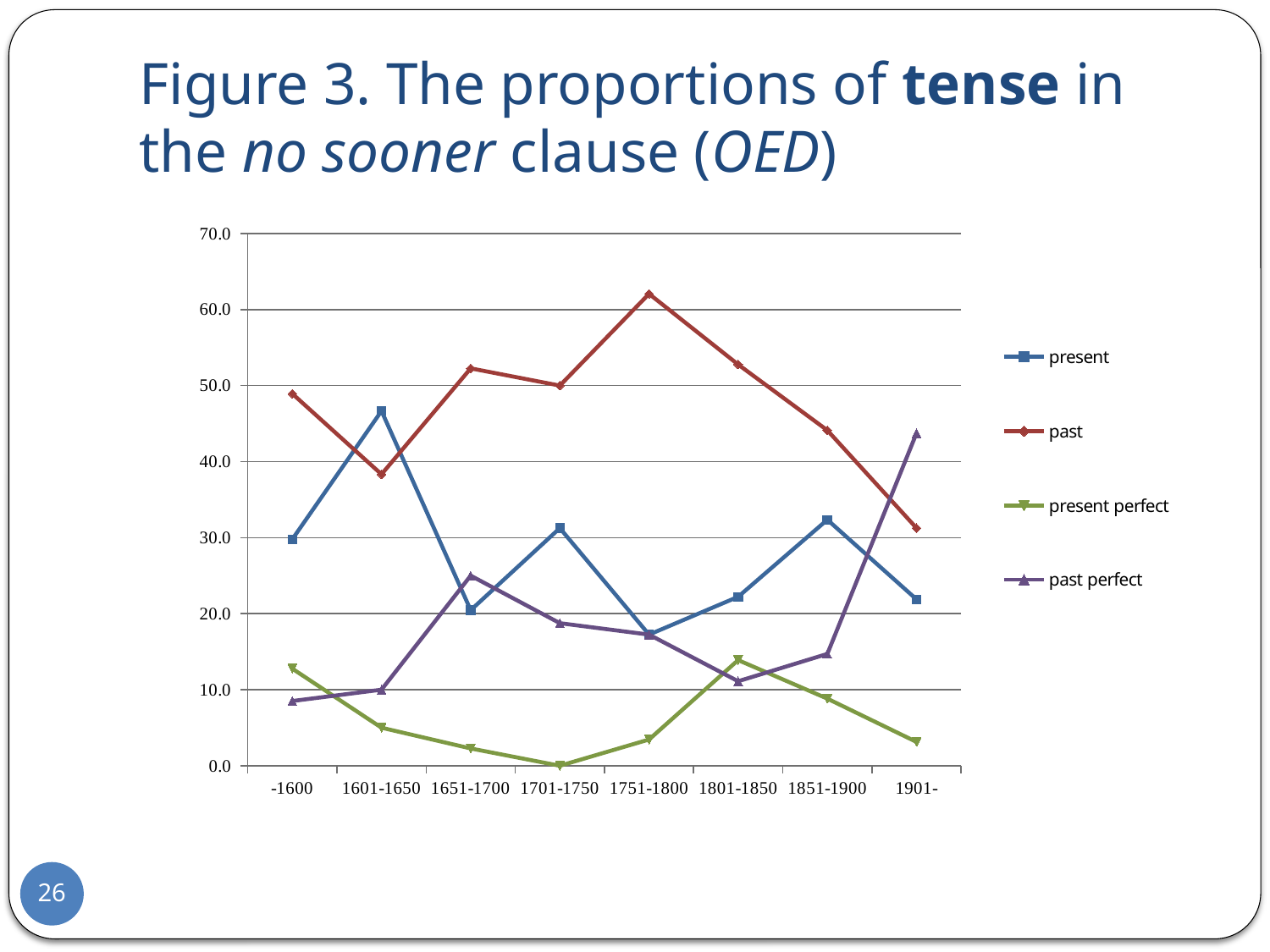
Which series has the lowest value in the 1701-1750 period? present perfect How many time periods are shown on the x axis? 8 Does the past series rise or fall from 1751-1800 to 1901-? fall Is the value for present in the 1601-1650 period greater or less than 40.0? greater Which is larger in the 1901- period, the value for past perfect or the value for past? past perfect How many series does the legend list? 4 Is the value for past perfect in the 1901- period greater or less than 40.0? greater Which series has the highest value in the 1751-1800 period? past In which period does the past series reach its highest value? 1751-1800 Is the value for past in the 1751-1800 period greater or less than 60.0? greater Which series is drawn in green? present perfect What kind of chart is shown on the slide? line chart